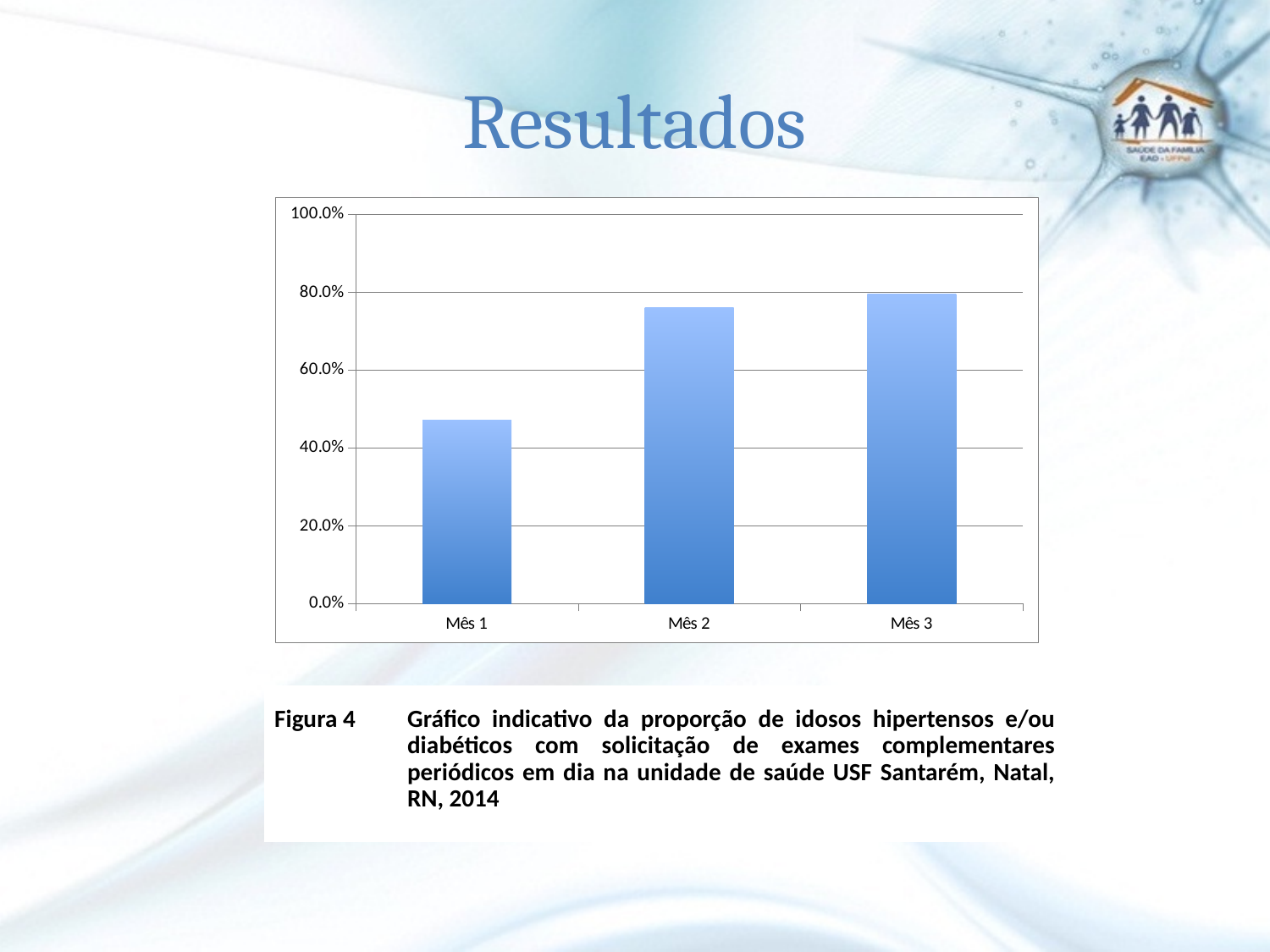
Which is larger, the value for Mês 1 or the value for Mês 2? Mês 2 How many categories (months) are plotted on the chart? 3 Is the value for Mês 1 greater or less than 60.0%? less Do the values rise or fall from Mês 1 to Mês 3? rise Is the value for Mês 1 greater or less than 40.0%? greater Is the value for Mês 2 greater or less than 60.0%? greater Which month has the lowest value on the chart? Mês 1 Which month has the highest value on the chart? Mês 3 What kind of chart is shown on the slide? bar chart What is the highest value shown on the vertical axis of the chart? 100.0%